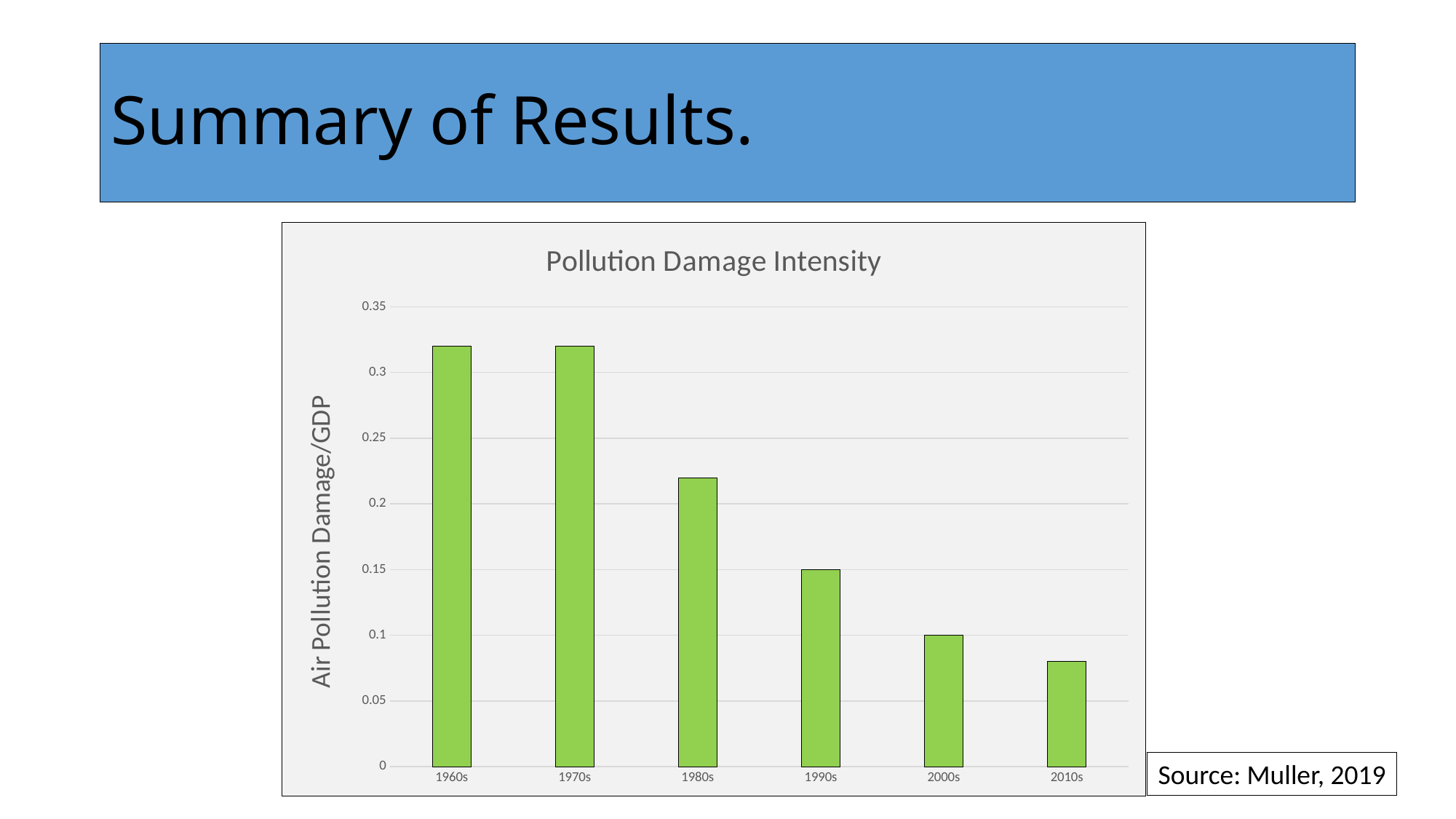
Do the values rise or fall from the 1960s to the 2010s? fall How many decades are shown on the x axis of the chart? 6 What kind of chart is shown on the slide? bar chart Is the value for the 1980s greater or less than 0.2? greater What is the label on the vertical axis of the chart? Air Pollution Damage/GDP Is the value for the 2010s greater or less than 0.1? less Which has a higher Air Pollution Damage/GDP, the 1980s or the 1990s? 1980s Is the value for the 1960s greater or less than 0.3? greater Which decade has the lowest Air Pollution Damage/GDP? 2010s What is the title of the chart? Pollution Damage Intensity What is the Air Pollution Damage/GDP value for the 1990s? 0.15 What is the Air Pollution Damage/GDP value for the 2000s? 0.1